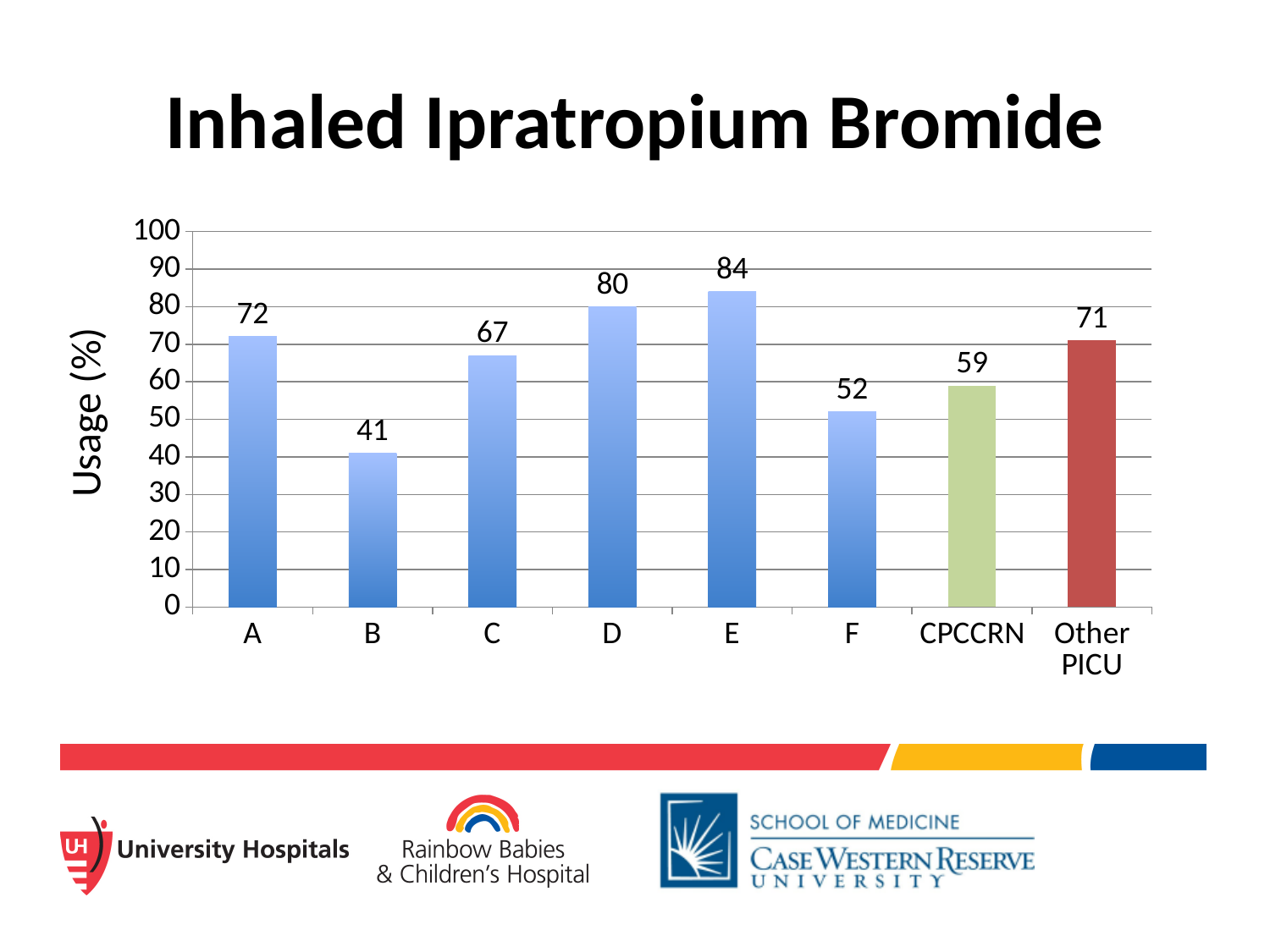
What is the usage (%) for site D? 80 How many categories are shown on the x axis? 8 What is the difference in usage between CPCCRN and Other PICU? 12 Is the usage for site F greater or less than 60? less Which has higher usage, site A or site C? A What is the usage (%) for CPCCRN? 59 What kind of chart is shown on the slide? bar chart What is the title of the slide? Inhaled Ipratropium Bromide What is the difference in usage between site E and site B? 43 Which category has the highest usage? E What is the usage (%) for Other PICU? 71 Which category has the lowest usage? B